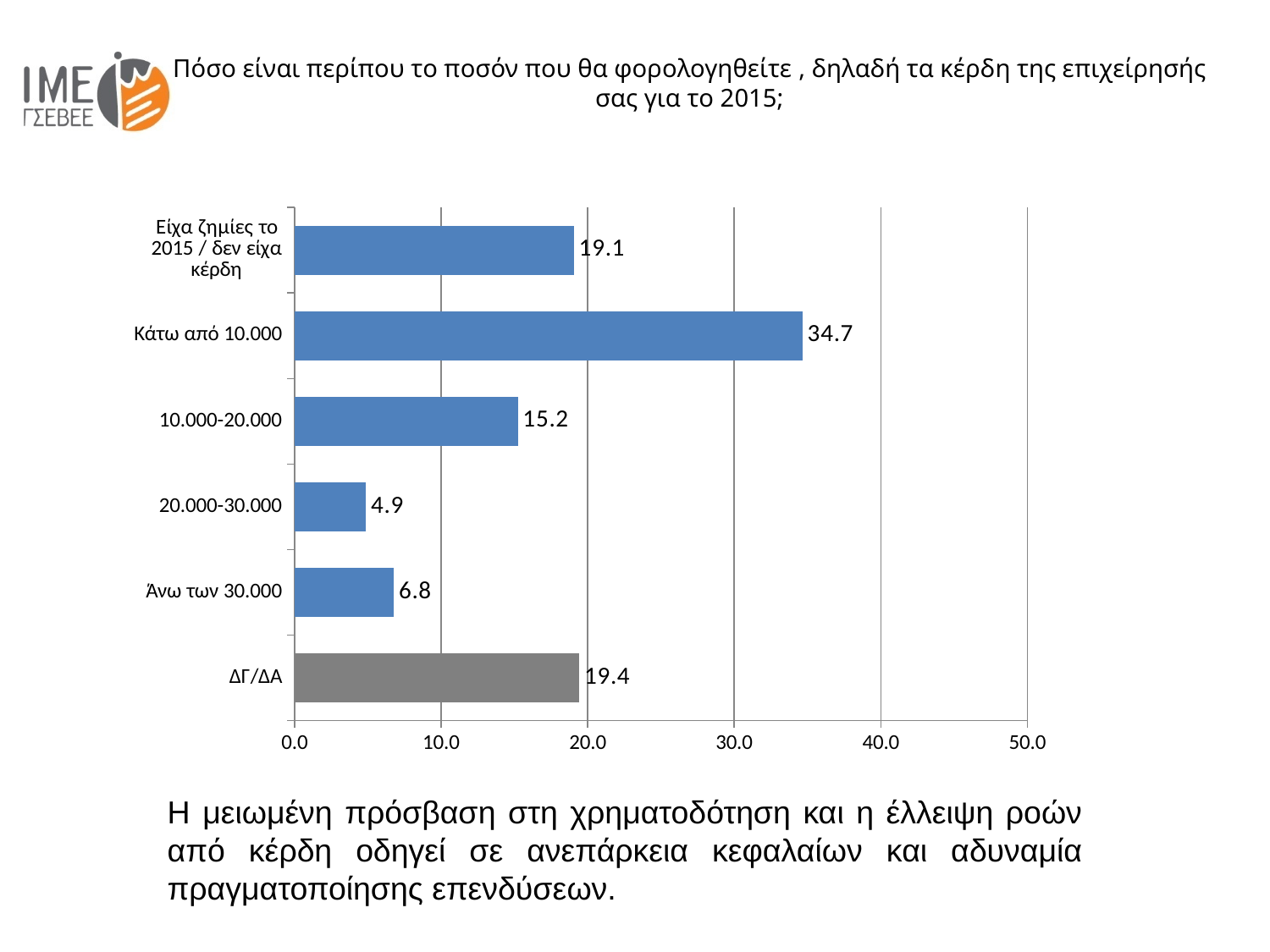
Which category has the lowest value? 20.000-30.000 How many categories are shown in the chart? 6 Is the value for "Κάτω από 10.000" greater or less than 30.0? greater What is the difference between the values for "Κάτω από 10.000" and "10.000-20.000"? 19.5 What is the value for the category "ΔΓ/ΔΑ"? 19.4 Which bar is coloured differently (grey) from the others? ΔΓ/ΔΑ What kind of chart is shown on the slide? Bar chart What is the value for the category "Κάτω από 10.000"? 34.7 What is the difference between the values for "ΔΓ/ΔΑ" and "Είχα ζημίες το 2015 / δεν είχα κέρδη"? 0.3 Which category has the highest value? Κάτω από 10.000 What is the value for the category "20.000-30.000"? 4.9 Which is larger, the value for "Άνω των 30.000" or the value for "20.000-30.000"? Άνω των 30.000